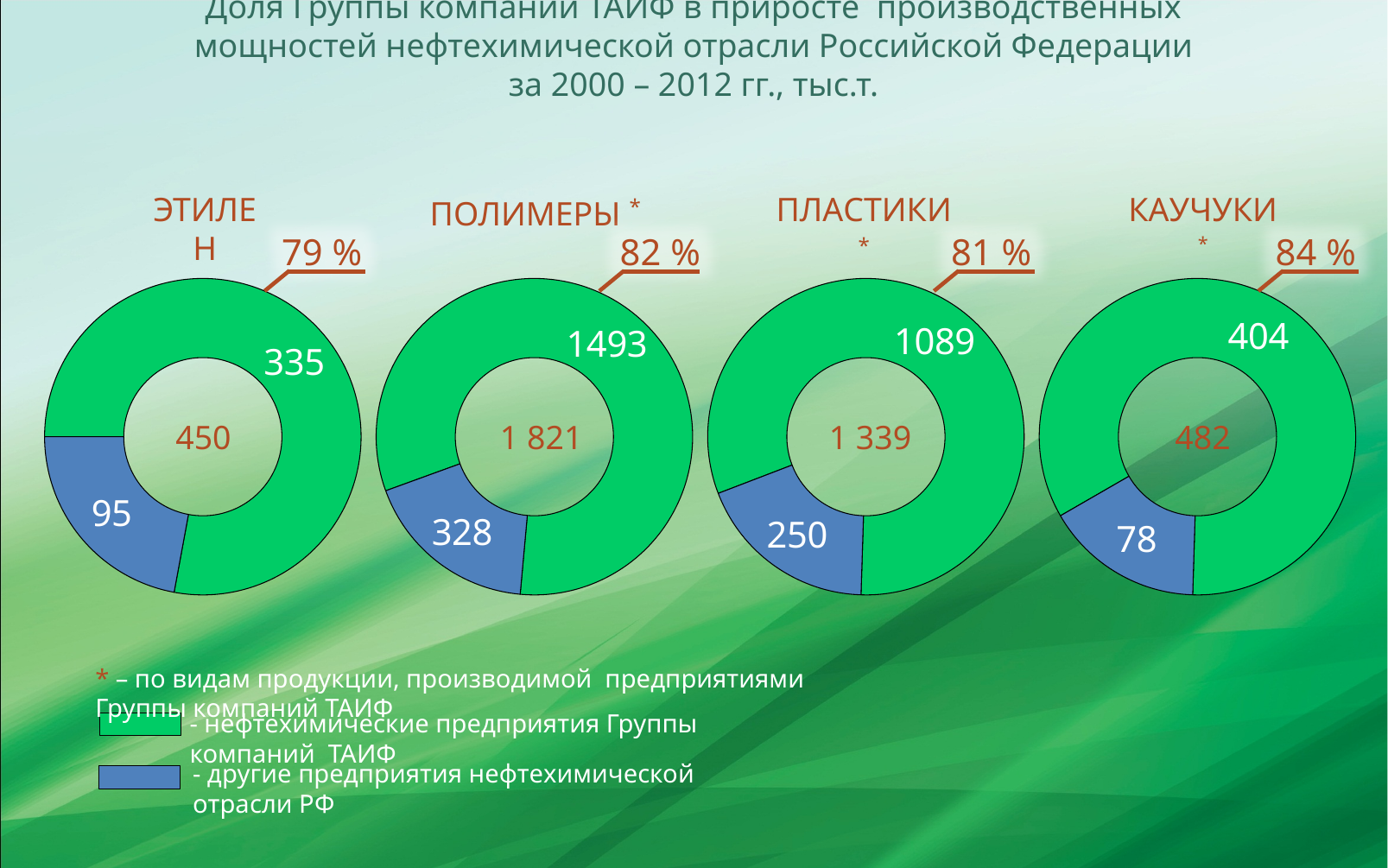
How many donut charts are shown on the slide? 4 In the ЭТИЛЕН chart, which segment is larger, the green one or the blue one? the green one How many series does the legend list? 2 In the ПЛАСТИКИ chart, what is the difference between the green segment (1089) and the blue segment (250)? 839 In the ПОЛИМЕРЫ chart, what is the value for the green segment (нефтехимические предприятия Группы компаний ТАИФ)? 1493 In the КАУЧУКИ chart, what share of the total does the green segment (Группа компаний ТАИФ) represent, as printed on the slide? 84 % In the ЭТИЛЕН chart, what is the value for the blue segment (другие предприятия нефтехимической отрасли РФ)? 95 Which of the four charts shows the highest share for the Группа компаний ТАИФ segment? КАУЧУКИ In the ПОЛИМЕРЫ chart, what is the total shown in the centre of the donut? 1 821 In the ЭТИЛЕН chart, what is the value for the green segment (нефтехимические предприятия Группы компаний ТАИФ)? 335 In the ПЛАСТИКИ chart, what is the value for the blue segment (другие предприятия нефтехимической отрасли РФ)? 250 In the КАУЧУКИ chart, what is the value for the green segment (нефтехимические предприятия Группы компаний ТАИФ)? 404